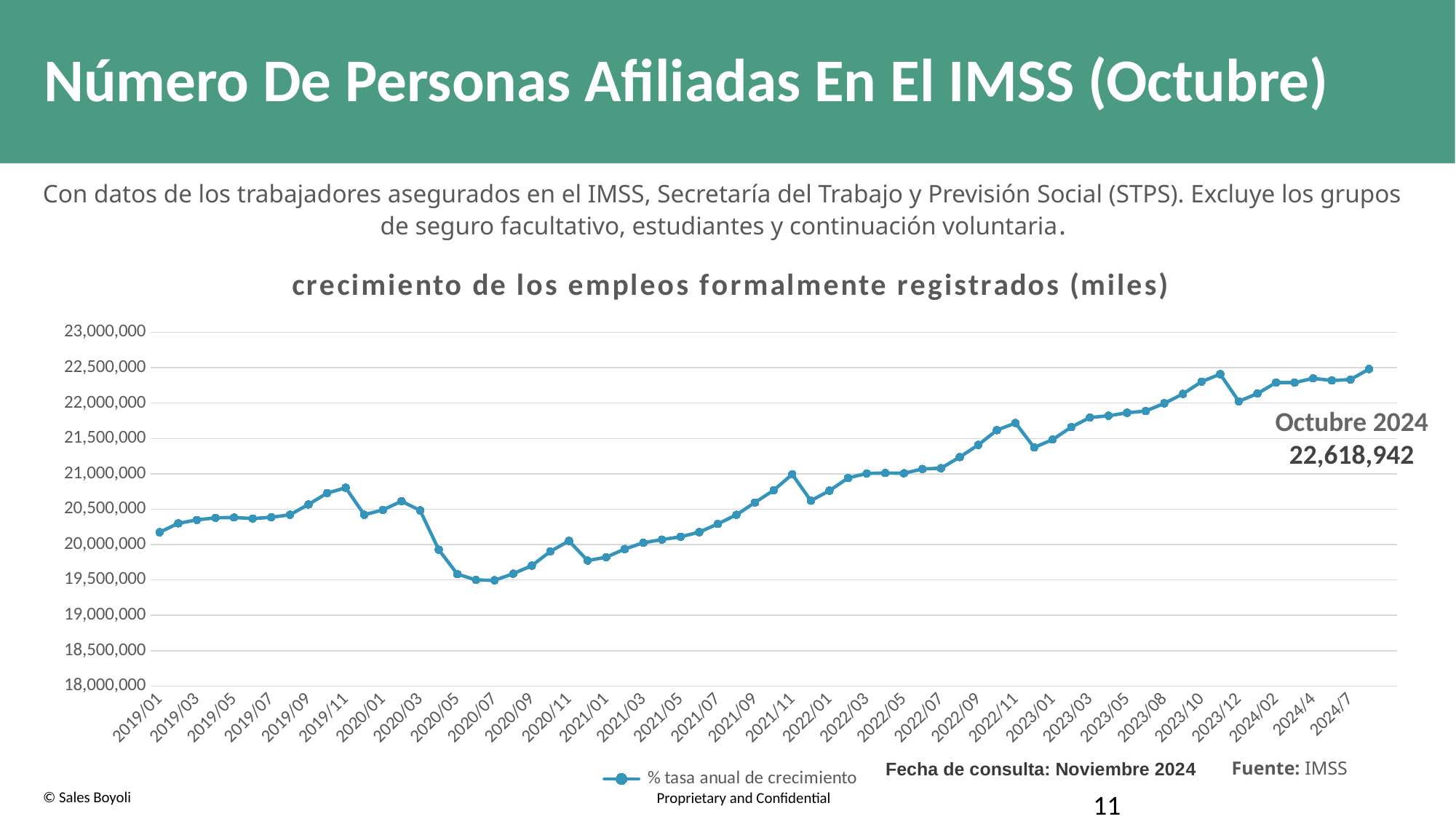
What is the legend entry of the series plotted in the chart? % tasa anual de crecimiento Overall, do the values rise or fall from 2019/01 to the end of the series? rise Which is larger, the value for 2019/11 or the value for 2020/07? 2019/11 Which is larger, the value for 2023/10 or the value for 2023/12? 2023/10 What value does the slide give for Octubre 2024? 22,618,942 Is the value for 2023/10 greater or less than 22,000,000? greater What is the title of the chart? crecimiento de los empleos formalmente registrados (miles) Is the value for 2022/11 greater or less than 21,500,000? greater Is the value for 2020/07 greater or less than 20,000,000? less How many series does the chart legend list? 1 What kind of chart is shown on the slide? line chart